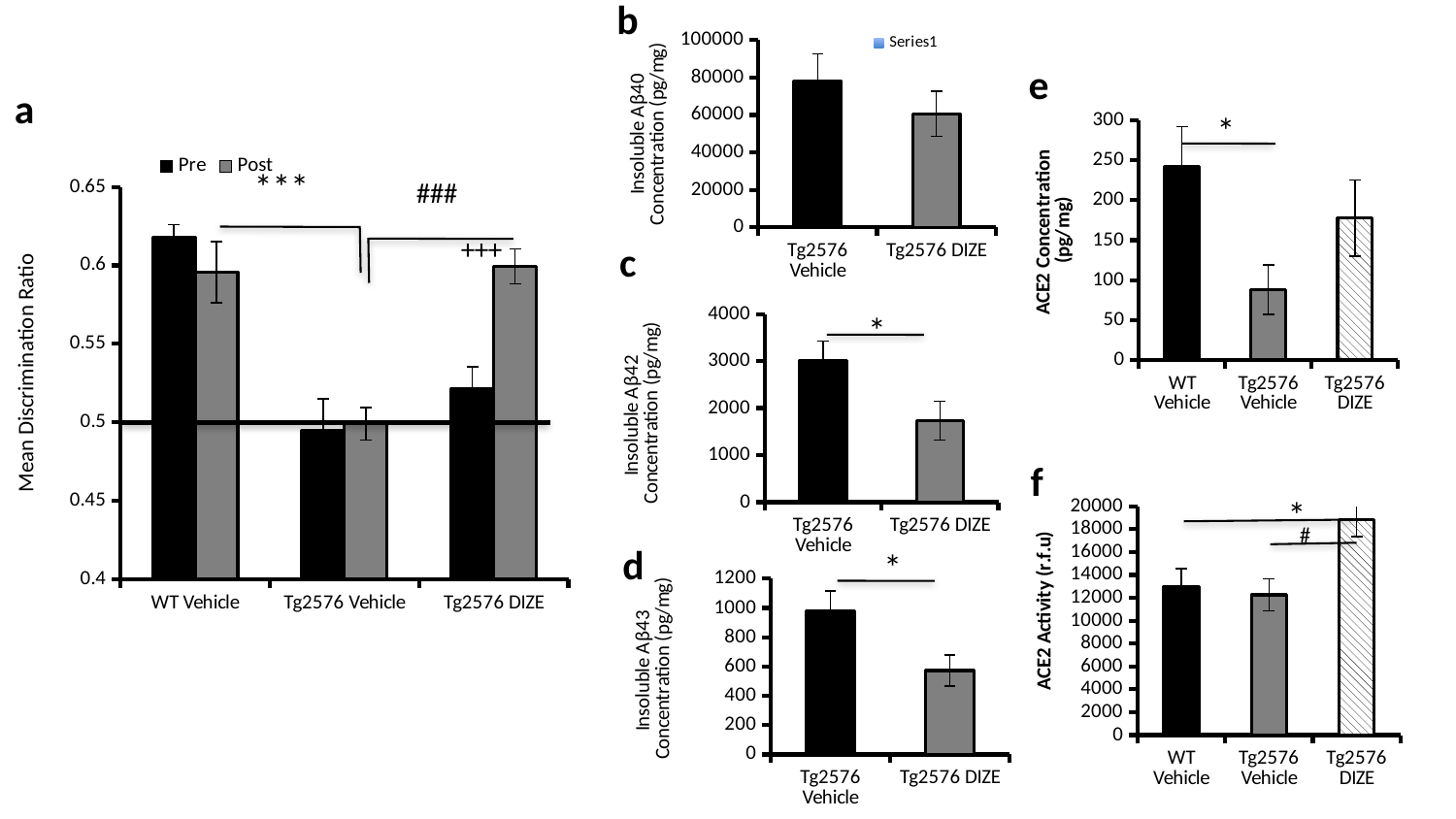
In chart d (Insoluble Aβ43 Concentration), is the value for Tg2576 DIZE greater or less than 400? greater In chart a (Mean Discrimination Ratio), how many series does the legend list? 2 What kind of chart is chart e (ACE2 Concentration)? bar chart In chart b (Insoluble Aβ40 Concentration), is the value for Tg2576 Vehicle greater or less than 60000? greater In chart a (Mean Discrimination Ratio), is the Pre value for WT Vehicle greater or less than 0.6? greater In chart e (ACE2 Concentration), which category has the lowest value? Tg2576 Vehicle In chart a (Mean Discrimination Ratio), for Tg2576 DIZE, which is larger, the Pre value or the Post value? Post In chart a (Mean Discrimination Ratio), how many categories are shown on the x axis? 3 In chart f (ACE2 Activity), which category has the highest value? Tg2576 DIZE In chart b (Insoluble Aβ40 Concentration), which is larger, Tg2576 Vehicle or Tg2576 DIZE? Tg2576 Vehicle